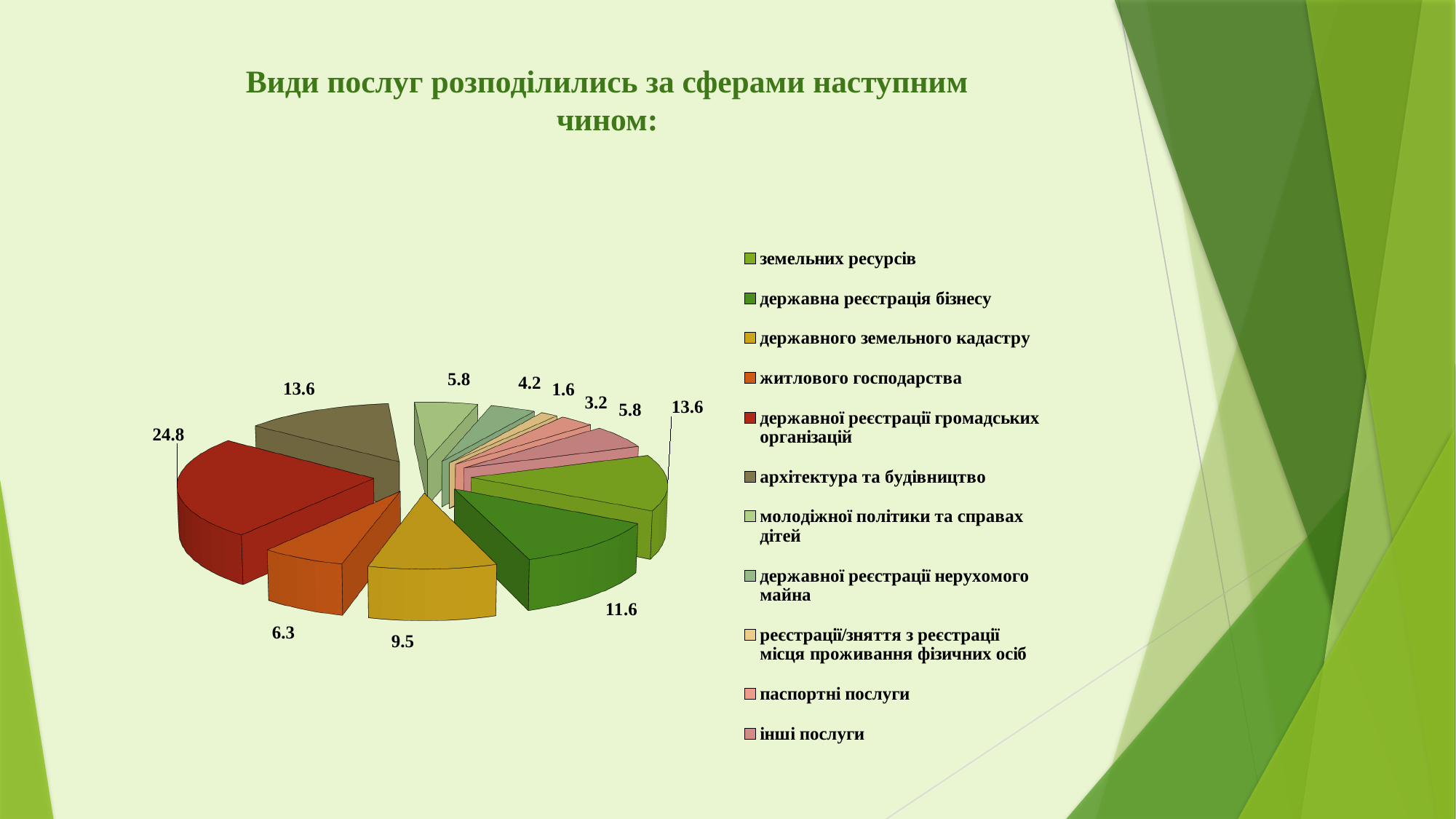
What kind of chart is shown on the slide? pie chart What is the difference between the values for державної реєстрації громадських організацій and архітектура та будівництво? 11.2 What is the value for державного земельного кадастру? 9.5 Which is larger, the value for державного земельного кадастру or the value for житлового господарства? державного земельного кадастру Which category has the largest slice? державної реєстрації громадських організацій How many slices does the pie chart have? 11 How many entries does the legend list? 11 What is the value for державна реєстрація бізнесу? 11.6 What is the value for житлового господарства? 6.3 Which category has the smallest slice? реєстрації/зняття з реєстрації місця проживання фізичних осіб What is the value for державної реєстрації громадських організацій? 24.8 What is the title of the chart on the slide? Види послуг розподілились за сферами наступним чином: